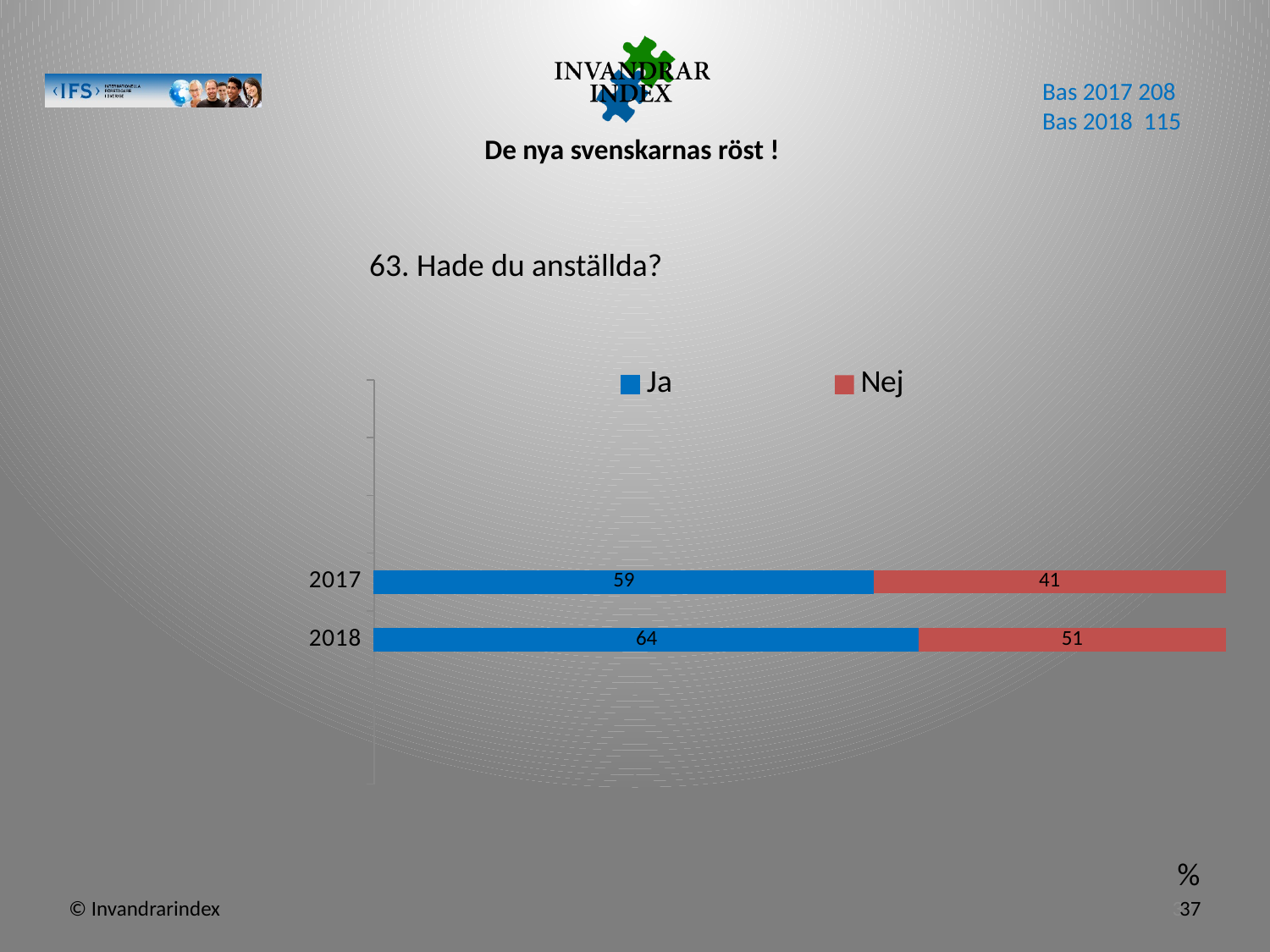
What is the value for Nej in 2017? 41 What is the difference between the Nej values for 2018 and 2017? 10 How many series does the legend list? 2 What kind of chart is shown on the slide? Stacked bar chart How many years are shown on the chart? 2 Is the value for Ja in 2017 larger than the value for Nej in 2017? Yes What is the value for Ja in 2017? 59 Which year has the higher value for Ja? 2018 What is the value for Nej in 2018? 51 Which year has the lower value for Nej? 2017 What is the difference between the Ja values for 2018 and 2017? 5 What is the value for Ja in 2018? 64